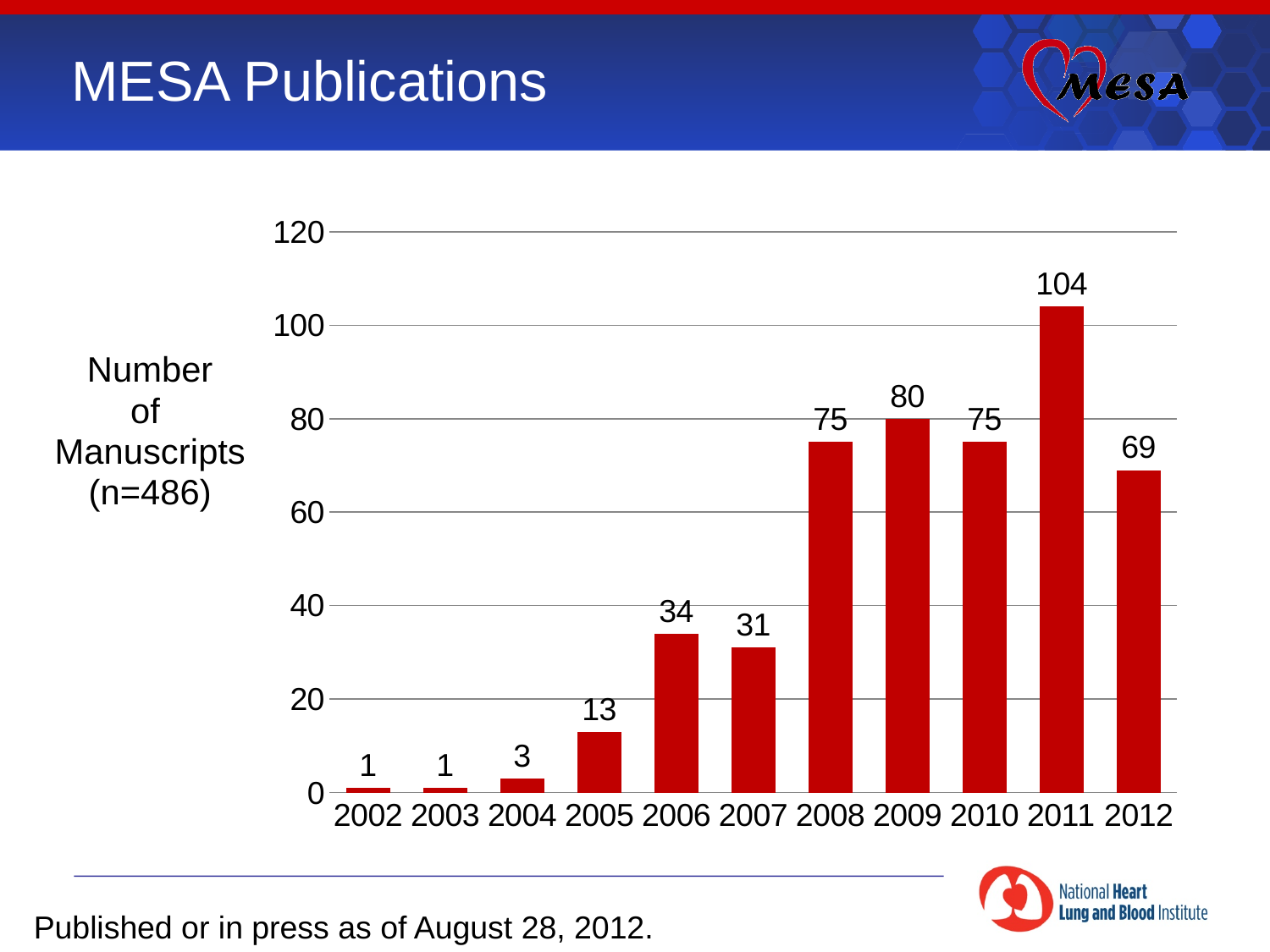
Which year has more manuscripts, 2009 or 2010? 2009 What is the label on the y axis of the chart? Number of Manuscripts (n=486) What is the difference between the number of manuscripts in 2011 and 2012? 35 What is the number of manuscripts for 2006? 34 What kind of chart is shown on the slide? Bar chart What is the lowest value shown on the chart? 1 Is the value for 2008 greater or less than 60? greater Do the values rise or fall from 2005 to 2006? Rise Which year has the highest number of manuscripts? 2011 How many manuscripts were published in 2011? 104 What is the total number of manuscripts for 2002, 2003 and 2004 combined? 5 How many years are shown on the x axis? 11